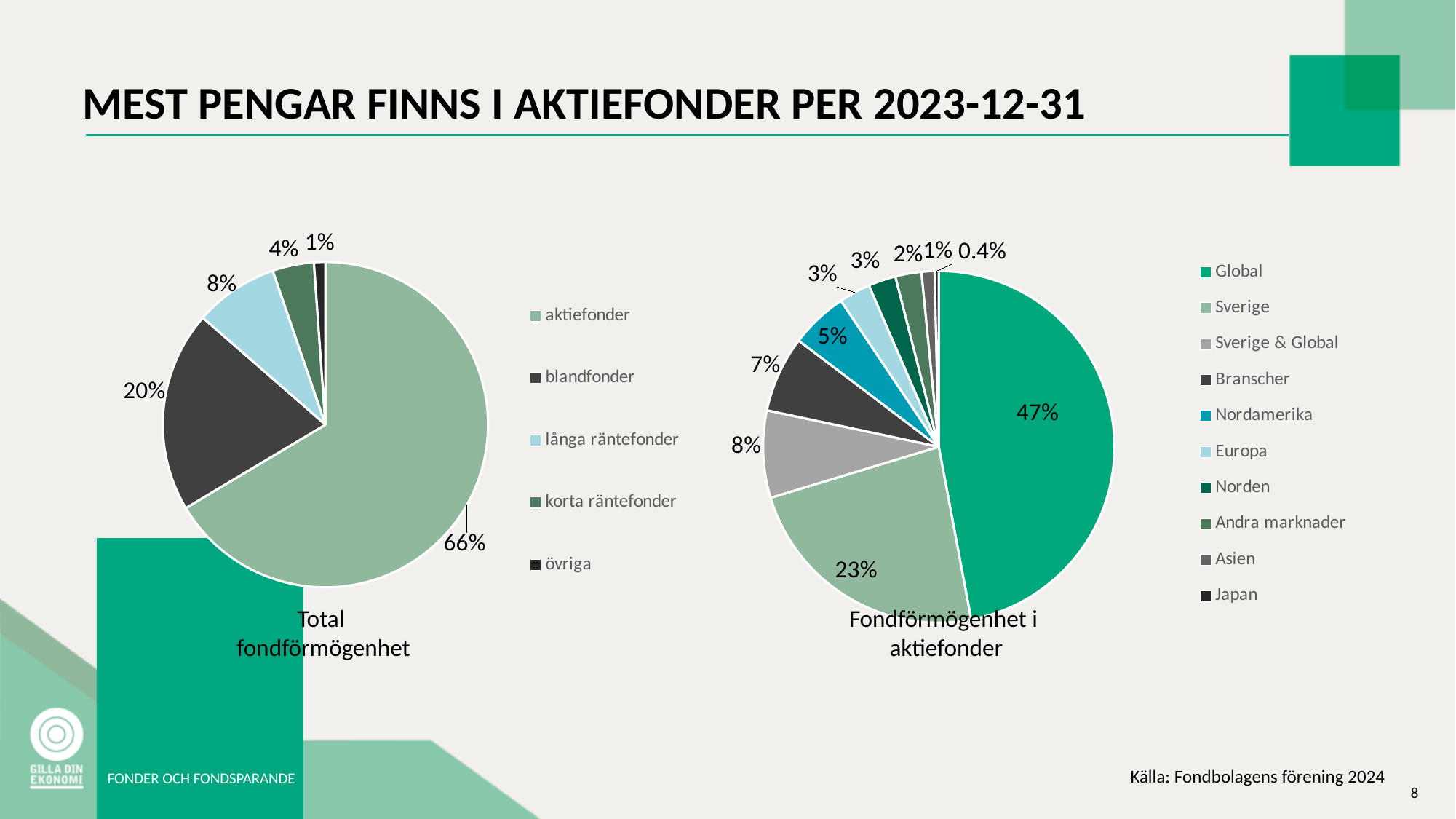
In the 'Fondförmögenhet i aktiefonder' chart, what share is Japan? 0.4% In the 'Total fondförmögenhet' chart, what share is blandfonder? 20% In the 'Fondförmögenhet i aktiefonder' chart, what share is Sverige? 23% In the 'Total fondförmögenhet' chart, which category has the smallest share? övriga What type of chart is the 'Total fondförmögenhet' chart? Pie chart In the 'Total fondförmögenhet' chart, what share is aktiefonder? 66% In the 'Fondförmögenhet i aktiefonder' chart, which category has the largest share? Global How many categories does the legend of the 'Total fondförmögenhet' chart list? 5 In the 'Fondförmögenhet i aktiefonder' chart, what share is Global? 47% In the 'Fondförmögenhet i aktiefonder' chart, which is larger: Branscher or Nordamerika? Branscher In the 'Total fondförmögenhet' chart, what is the difference between the shares of blandfonder and långa räntefonder? 12% How many categories does the legend of the 'Fondförmögenhet i aktiefonder' chart list? 10